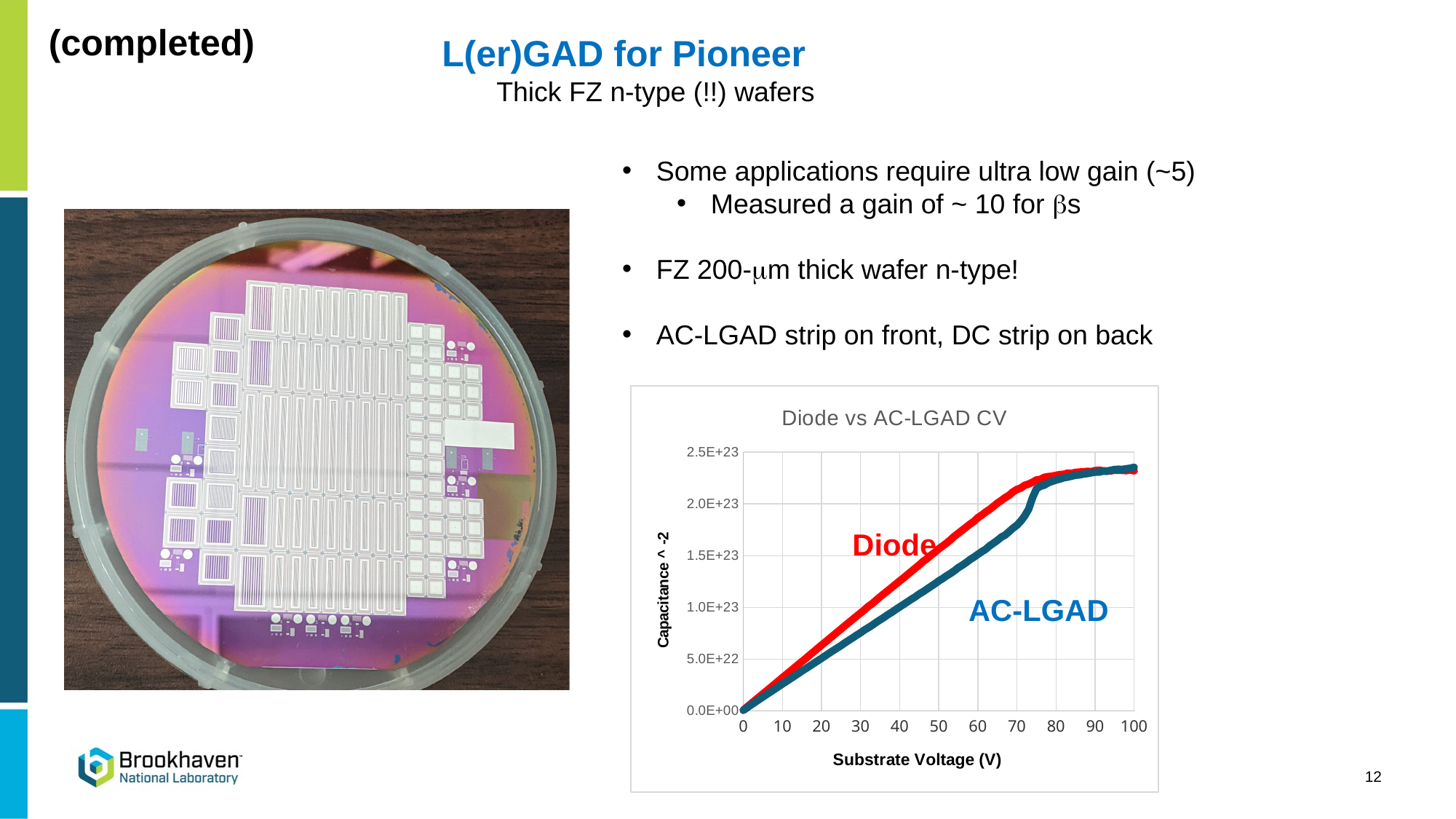
What kind of chart is shown on the slide? line chart What is the highest substrate voltage shown on the x axis of the chart? 100 How many series are plotted in the chart? 2 Is the value of the AC-LGAD series at 70 V greater or less than 2.0E+23? less At a substrate voltage of 50 V, which series has the larger value, Diode or AC-LGAD? Diode What is the title of the chart? Diode vs AC-LGAD CV What is the x-axis title of the chart? Substrate Voltage (V) Is the value of the Diode series at 50 V greater or less than 1.0E+23? greater Do the values of the Diode series rise or fall as substrate voltage increases? rise Is the value of the Diode series at 100 V greater or less than 2.0E+23? greater